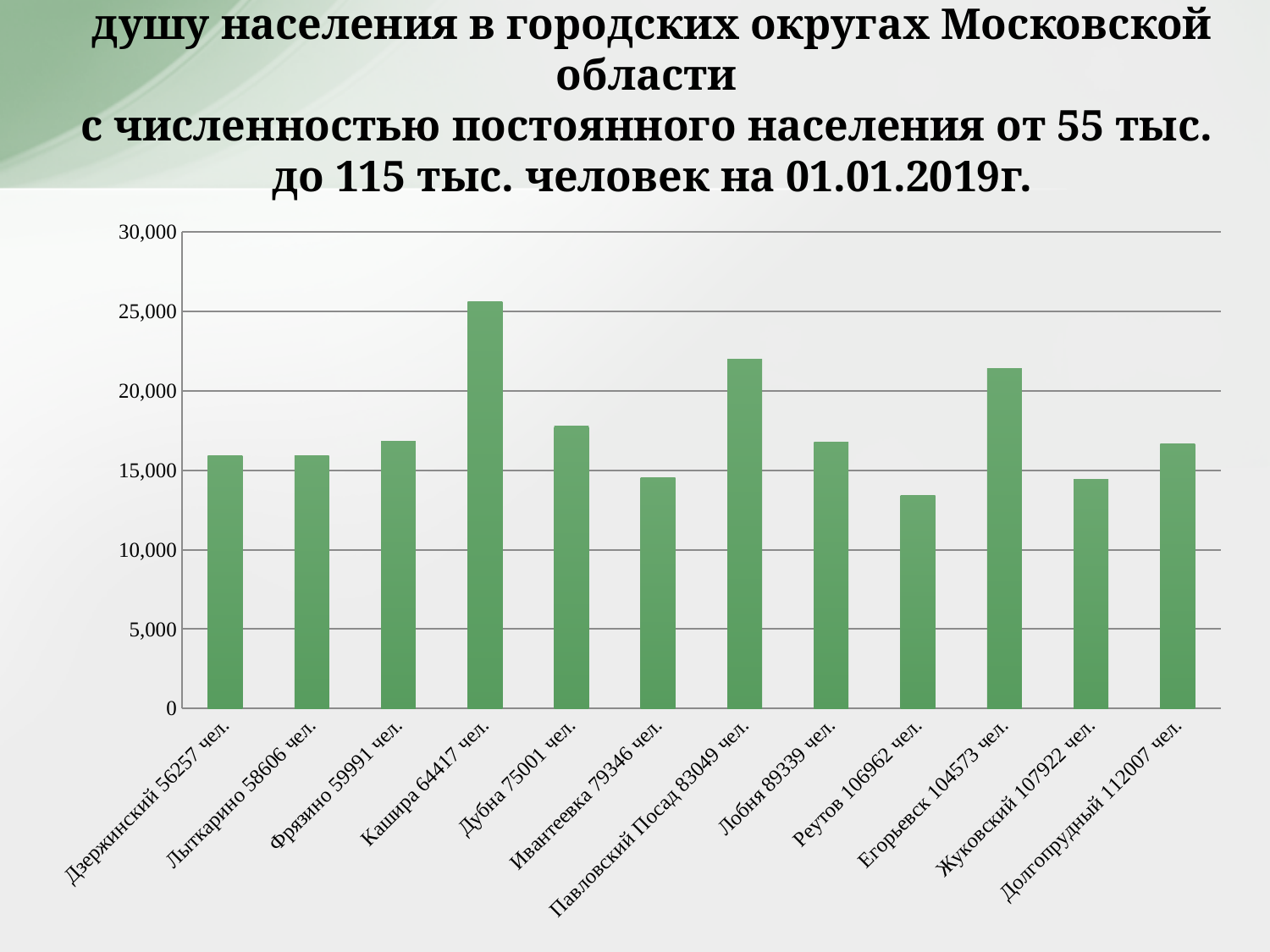
Is the value for Дубна greater or less than 15,000? greater Which is larger, the value for Дубна or the value for Ивантеевка? Дубна Which is larger, the value for Кашира or the value for Павловский Посад? Кашира What kind of chart is shown on the slide? bar chart Is the value for Павловский Посад greater or less than 20,000? greater Is the value for Кашира greater or less than 20,000? greater What is the maximum value shown on the vertical axis of the chart? 30,000 Which city district has the lowest bar on the chart? Реутов 106962 чел. Which city district has the highest bar on the chart? Кашира 64417 чел. How many city districts (categories) are plotted on the chart? 12